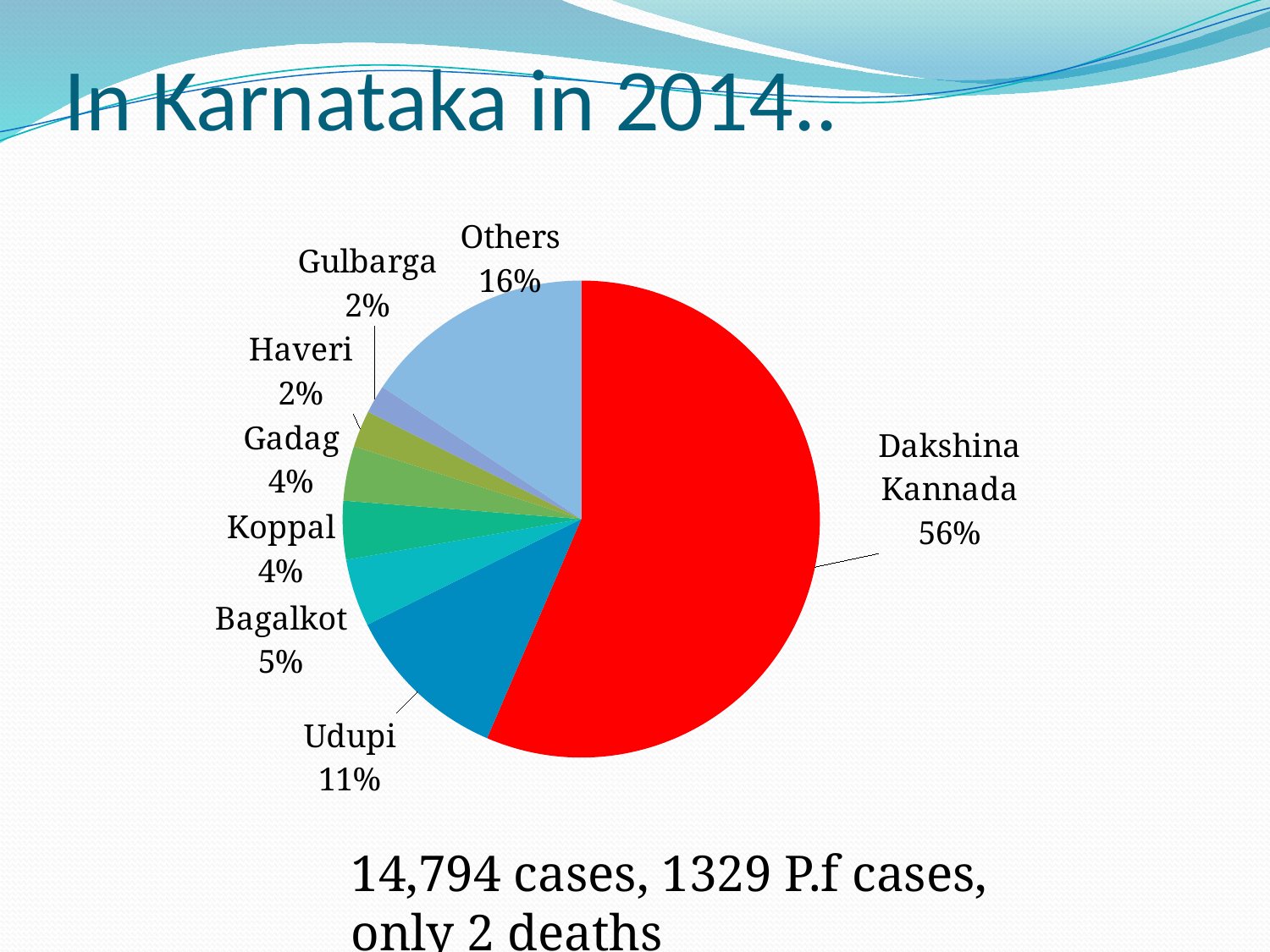
What percentage is shown for Bagalkot? 5% Which is larger, the slice for Others or the slice for Udupi? Others Which two categories each have a 2% share? Gulbarga and Haveri How many slices does the pie chart have? 8 What colour is the Dakshina Kannada slice? red Which category has the largest slice of the pie? Dakshina Kannada What percentage is shown for Others? 16% What is the difference in percentage points between Dakshina Kannada and Udupi? 45 What share of the pie does Dakshina Kannada account for? 56% What kind of chart is shown on the slide? pie chart What percentage is shown for Udupi? 11% What is the combined percentage of Gadag and Koppal? 8%